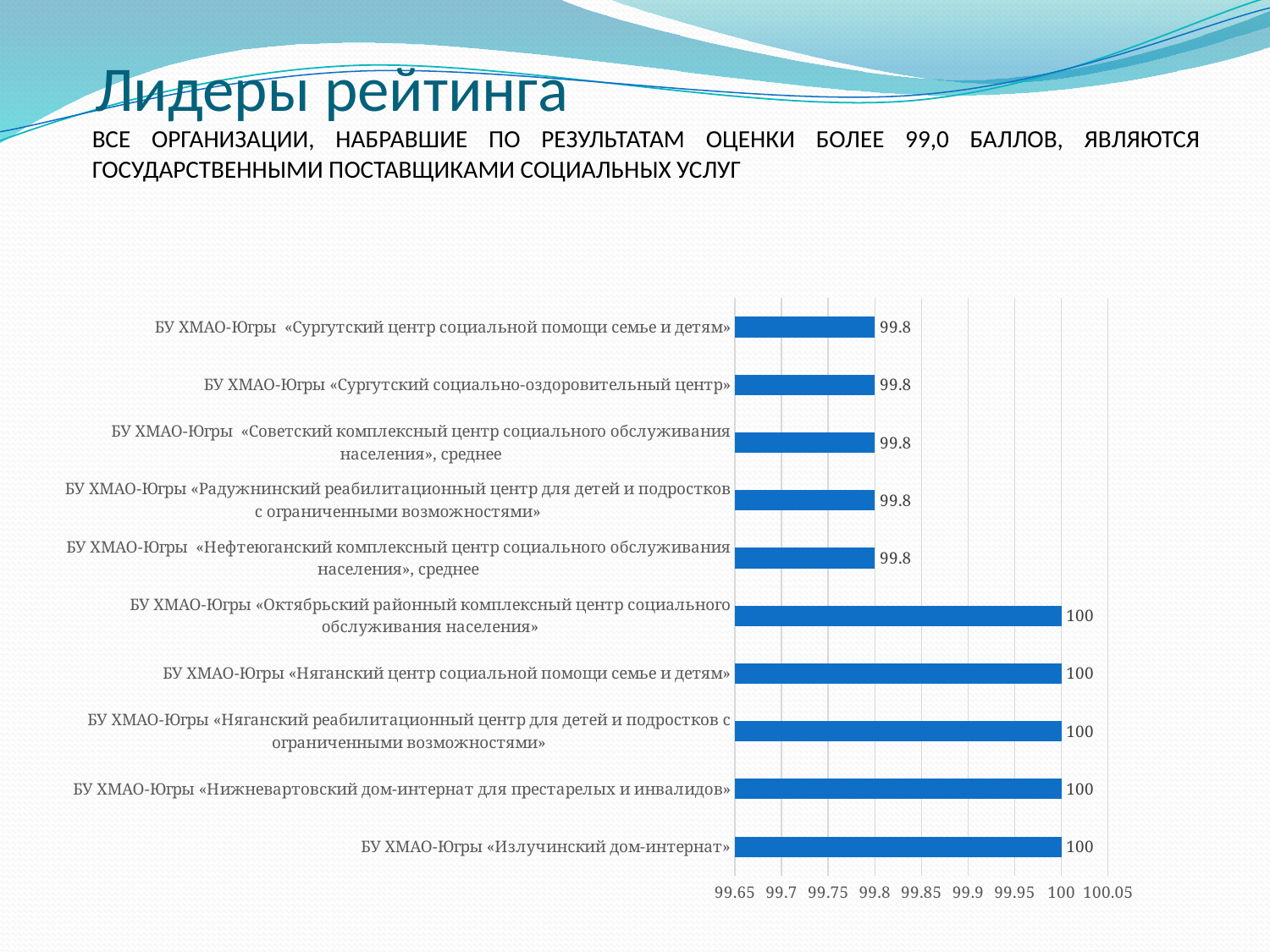
Is the value for БУ ХМАО-Югры «Советский комплексный центр социального обслуживания населения», среднее greater or less than 99.9? less What is the difference between the value for БУ ХМАО-Югры «Нижневартовский дом-интернат для престарелых и инвалидов» and the value for БУ ХМАО-Югры «Сургутский центр социальной помощи семье и детям»? 0.2 What is the title of the slide containing the chart? Лидеры рейтинга What is the value for БУ ХМАО-Югры «Няганский центр социальной помощи семье и детям»? 100 What is the value for БУ ХМАО-Югры «Излучинский дом-интернат»? 100 Is the value for БУ ХМАО-Югры «Няганский реабилитационный центр для детей и подростков с ограниченными возможностями» greater or less than 99.9? greater Which is larger: the value for БУ ХМАО-Югры «Октябрьский районный комплексный центр социального обслуживания населения» or the value for БУ ХМАО-Югры «Нефтеюганский комплексный центр социального обслуживания населения», среднее? БУ ХМАО-Югры «Октябрьский районный комплексный центр социального обслуживания населения» How many organisations in the chart have a value of 100? 5 What type of chart is shown on the slide? bar chart How many organisations (categories) are plotted in the chart? 10 What is the value for БУ ХМАО-Югры «Сургутский социально-оздоровительный центр»? 99.8 What is the value for БУ ХМАО-Югры «Радужнинский реабилитационный центр для детей и подростков с ограниченными возможностями»? 99.8